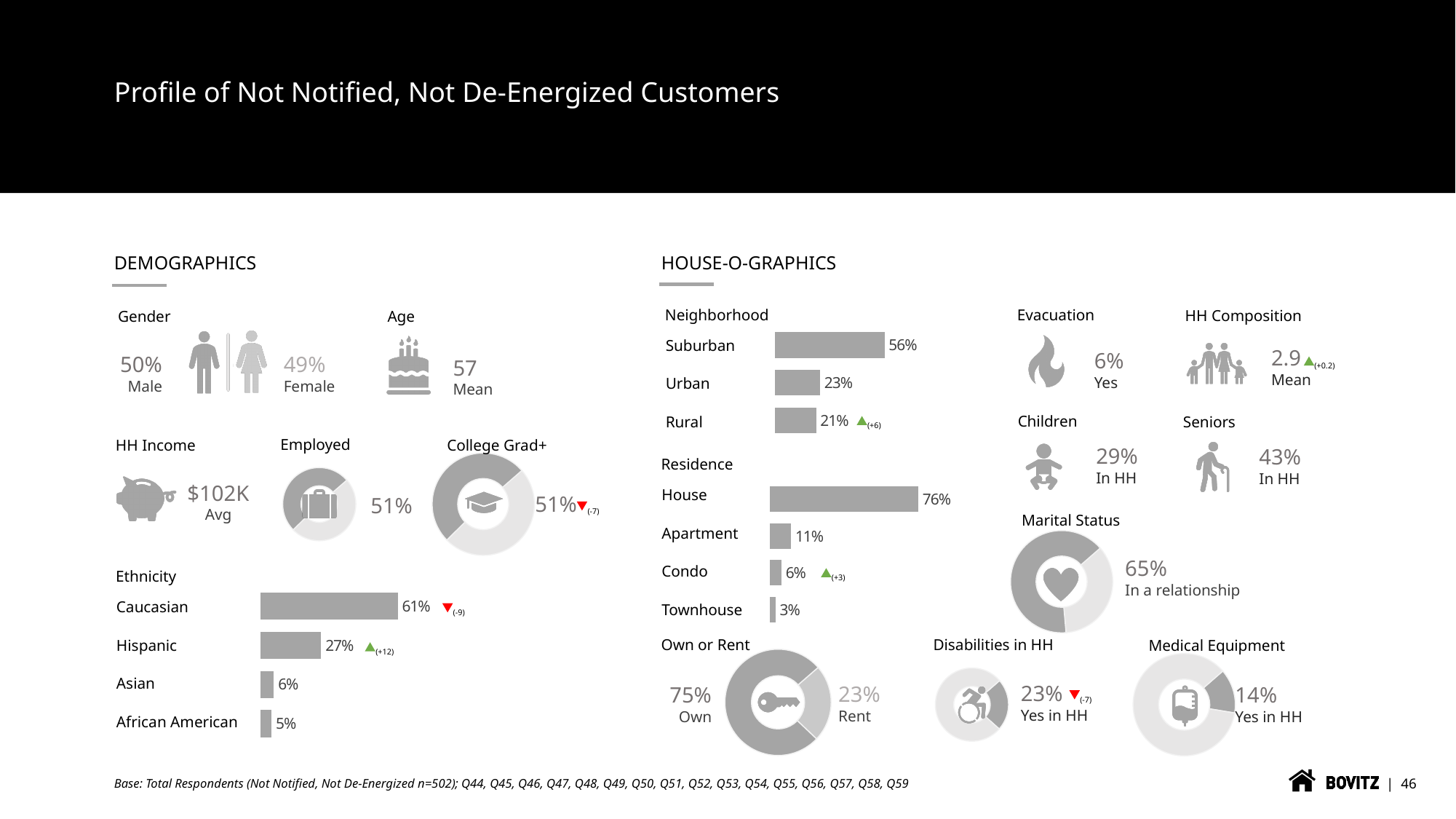
In the Ethnicity bar chart, which category has the lowest value? African American In the Neighborhood bar chart, which category has the highest value? Suburban In the Neighborhood bar chart, what percentage is shown for Urban? 23% How many categories does the Ethnicity bar chart show? 4 What kind of chart is used to show Ethnicity? Bar chart In the Residence bar chart, what percentage is shown for Apartment? 11% In the Residence bar chart, what is the difference between the House and Apartment values? 65% In the Ethnicity bar chart, what percentage is shown for Caucasian? 61% In the Own or Rent donut chart, what percentage of respondents rent? 23% In the Marital Status donut chart, what percentage are in a relationship? 65% In the Ethnicity bar chart, what is the difference between the Hispanic and Asian values? 21% In the Residence bar chart, which is larger, Condo or Townhouse? Condo